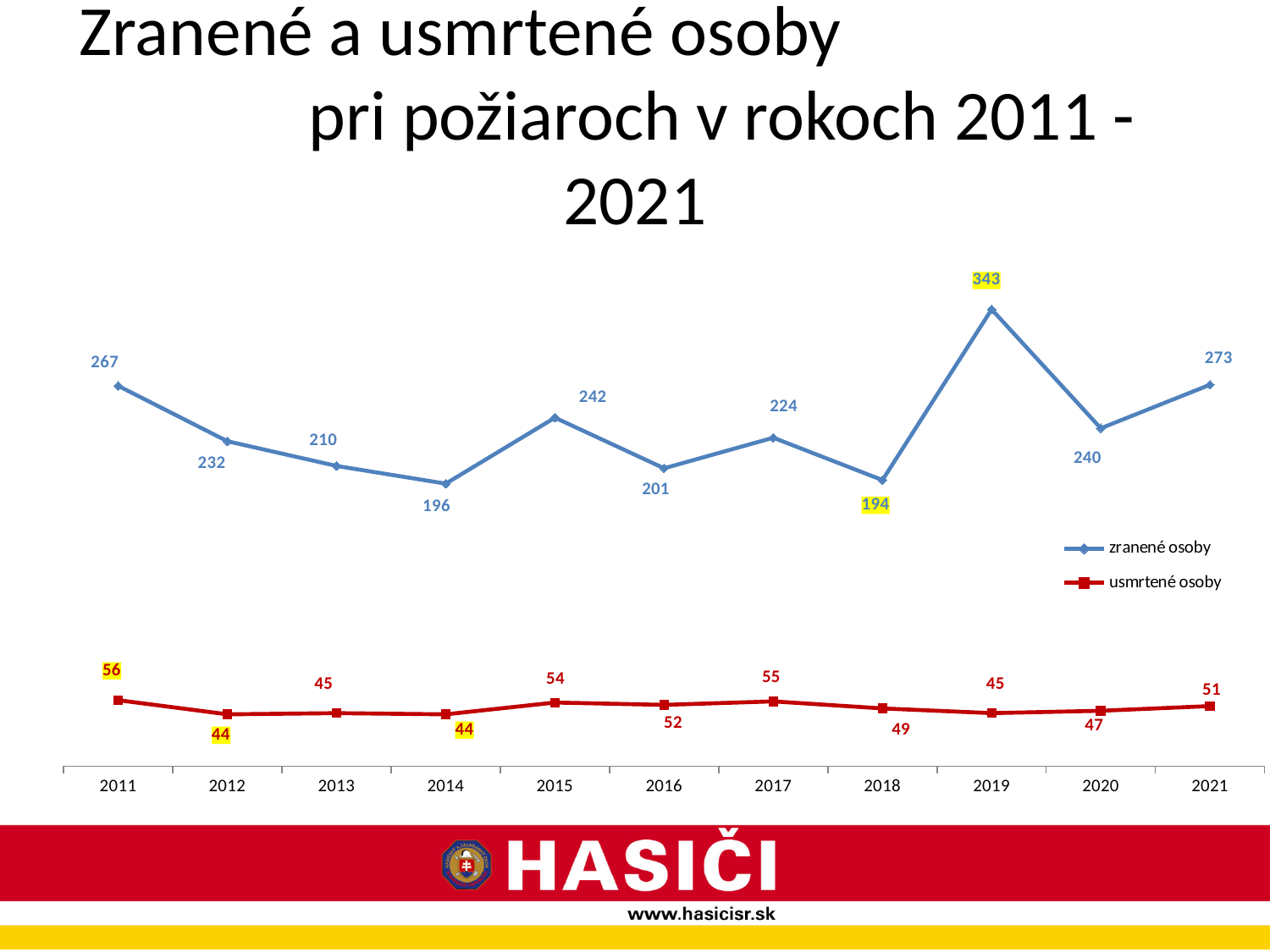
Which is larger: zranené osoby in 2015 or in 2017? 2015 What colour is the line for usmrtené osoby? red Which year has the lowest value for zranené osoby? 2018 What kind of chart is shown on the slide? line chart Which year has the highest value for zranené osoby? 2019 What is the difference between zranené osoby in 2019 and in 2018? 149 How many series does the legend list? 2 What is the value for usmrtené osoby in 2011? 56 Which year has the highest value for usmrtené osoby? 2011 What is the value for zranené osoby in 2019? 343 Did the value for zranené osoby rise or fall from 2011 to 2014? fall How many years are shown on the x axis? 11